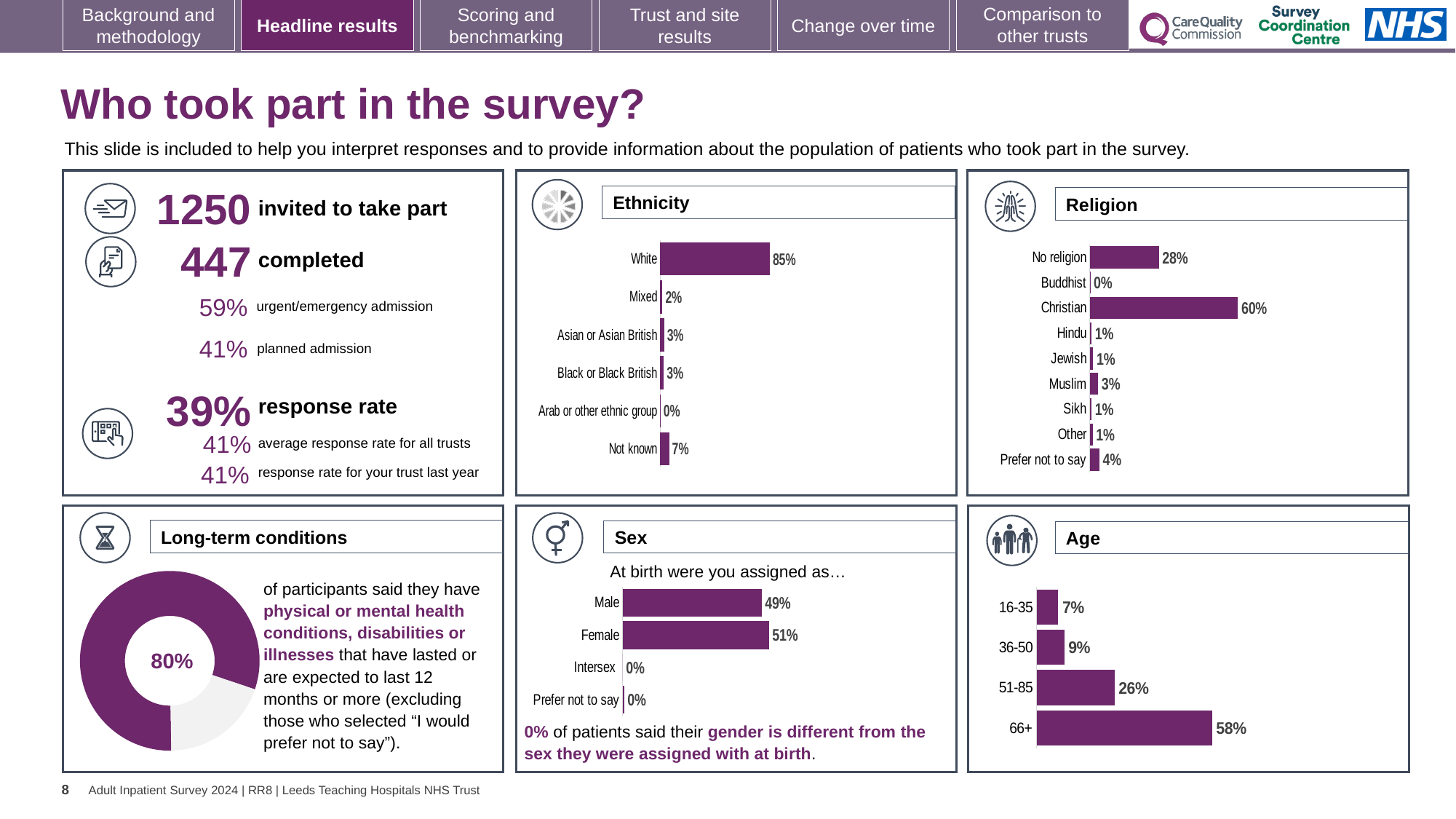
In the Sex chart, what is the value for Male? 49% In the Ethnicity chart, which category has the highest value? White In the Religion chart, how many categories are shown? 9 In the Ethnicity chart, how many categories are shown? 6 What kind of chart is used in the Long-term conditions panel? doughnut chart In the Religion chart, what is the difference between Christian and No religion? 32% In the Age chart, do the values rise or fall from 16-35 to 66+? rise In the Religion chart, what is the value for Christian? 60% In the Ethnicity chart, what percentage of respondents are White? 85% In the Age chart, which age group has the highest value? 66+ In the Sex chart, which is larger, Male or Female? Female In the Age chart, what is the value for 51-85? 26%